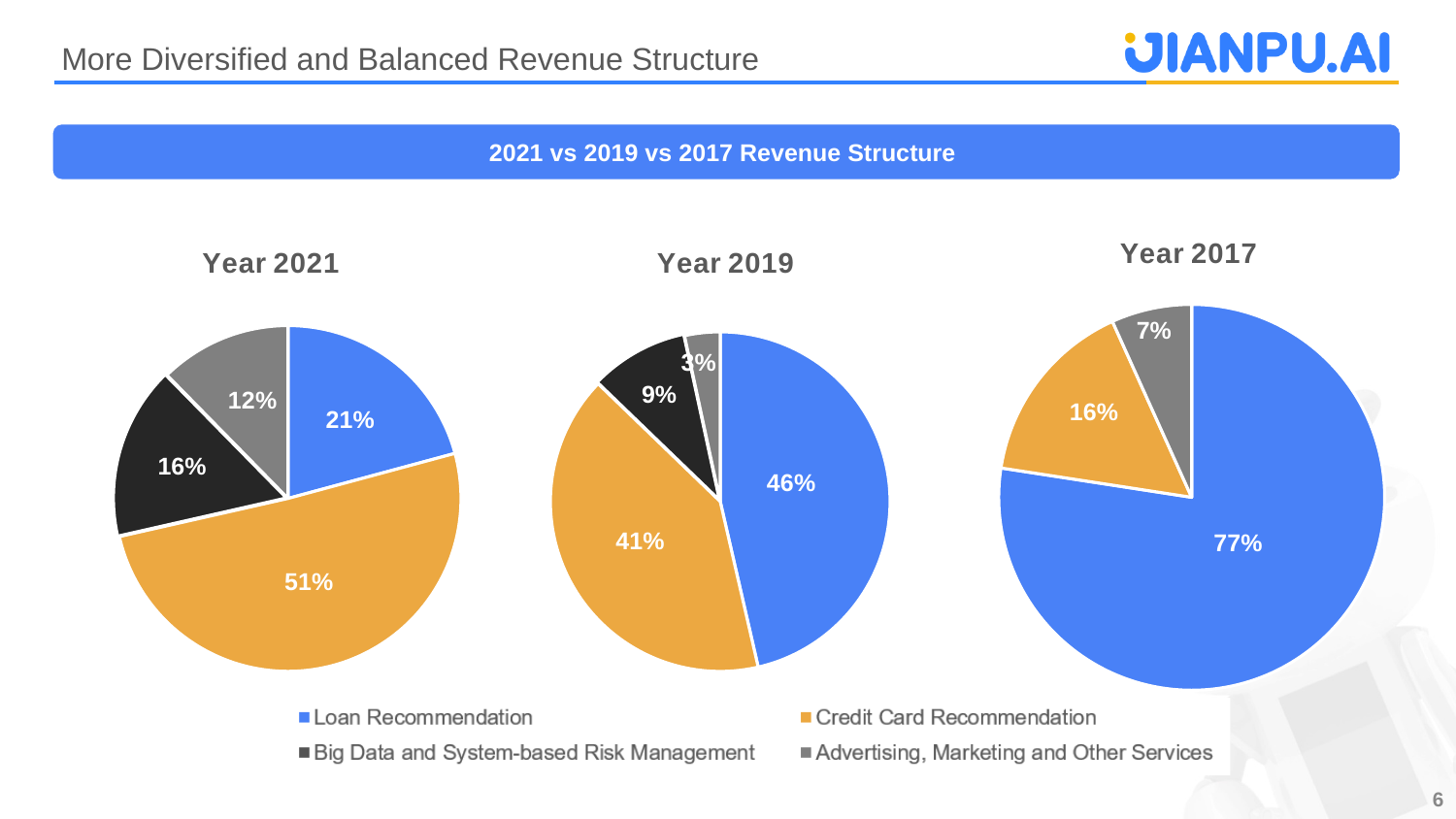
In the Year 2019 pie chart, which is larger: Loan Recommendation or Credit Card Recommendation? Loan Recommendation What kind of chart is used for Year 2021? Pie chart In the Year 2019 pie chart, what share does Loan Recommendation have? 46% In the Year 2021 pie chart, what share does Big Data and System-based Risk Management have? 16% In the Year 2021 pie chart, what share does Credit Card Recommendation have? 51% In the Year 2017 pie chart, which category has the largest share? Loan Recommendation In the Year 2019 pie chart, which category has the smallest share? Advertising, Marketing and Other Services In the Year 2021 pie chart, which category has the largest share? Credit Card Recommendation In the Year 2017 pie chart, what share does Advertising, Marketing and Other Services have? 7% How many categories does the legend list? 4 How many slices does the Year 2017 pie chart have? 3 In the Year 2021 pie chart, what is the difference between the Credit Card Recommendation share and the Loan Recommendation share? 30%